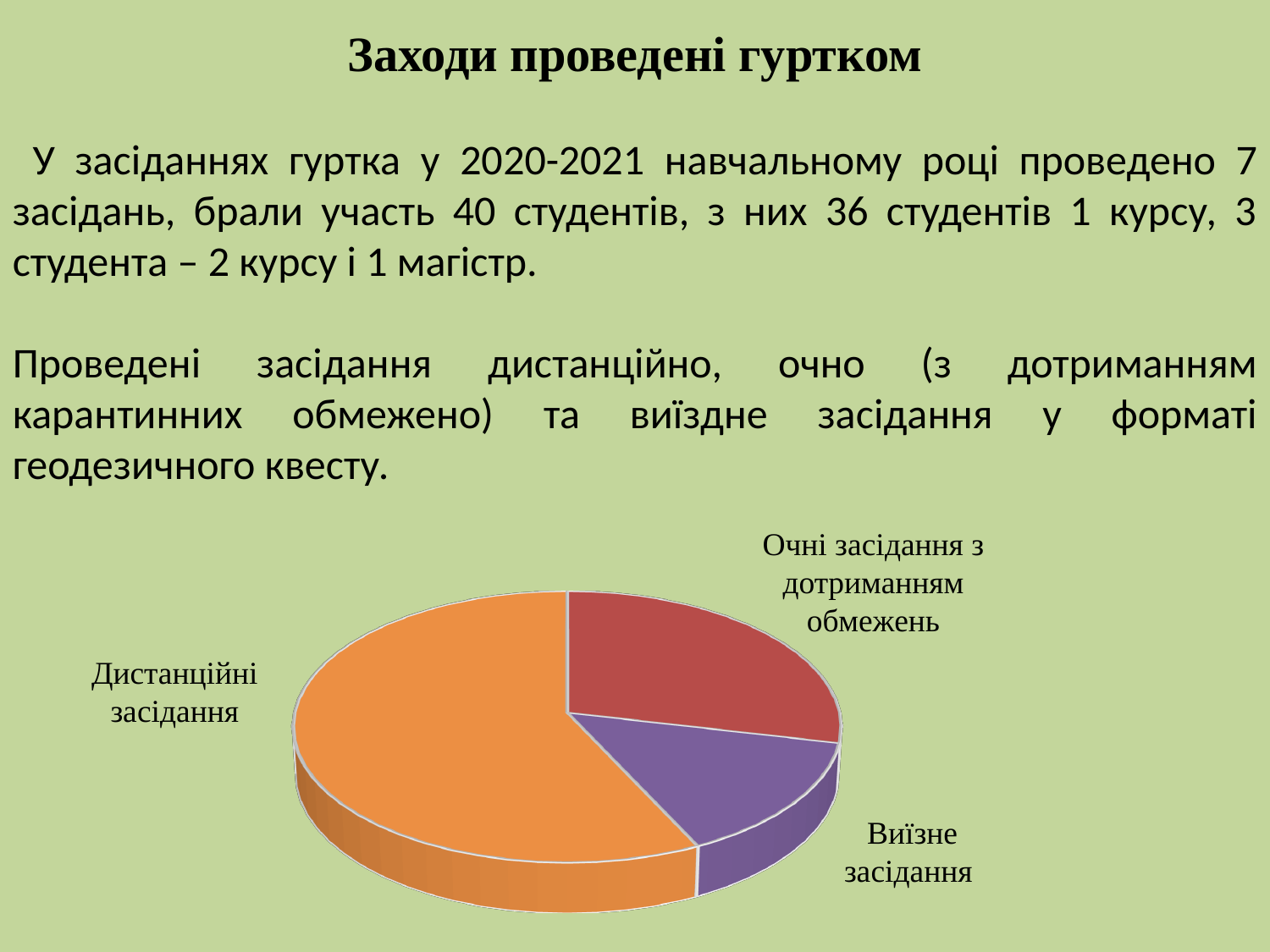
How many slices does the pie chart have? 3 Which category has the smallest slice of the pie chart? Виїзне засідання What colour is the slice for Дистанційні засідання? orange Which category has the largest slice of the pie chart? Дистанційні засідання Does the slice for Дистанційні засідання take up more or less than half of the pie? more Which slice is larger: Виїзне засідання or Дистанційні засідання? Дистанційні засідання Which slice is larger: Дистанційні засідання or Очні засідання з дотриманням обмежень? Дистанційні засідання Which slice is larger: Очні засідання з дотриманням обмежень or Виїзне засідання? Очні засідання з дотриманням обмежень What kind of chart is shown on the slide? pie chart What colour is the slice for Виїзне засідання? purple